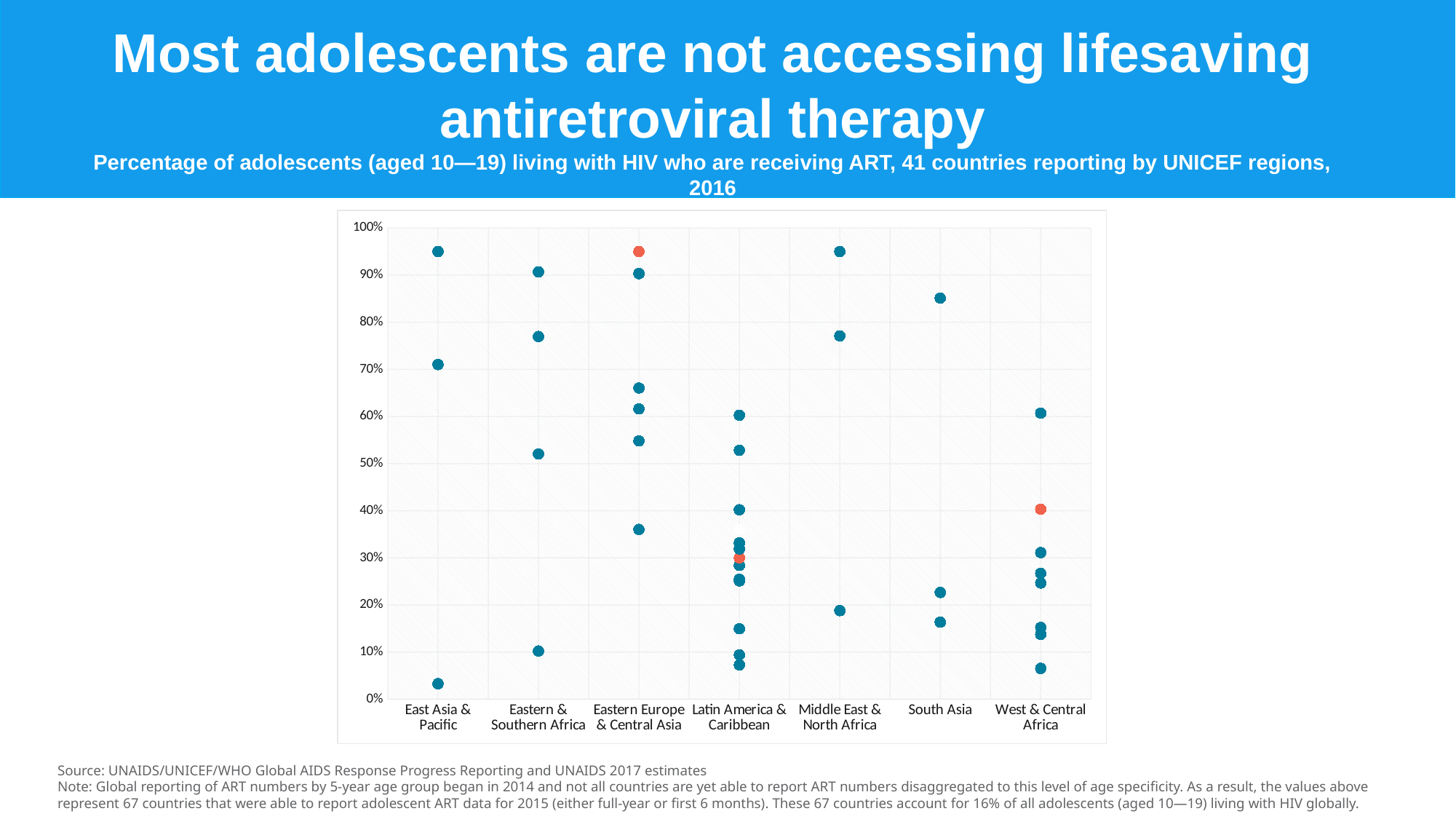
Is the highest value for South Asia greater or less than 80%? greater How many data points are plotted for South Asia? 3 Is the lowest value for Middle East & North Africa greater or less than 30%? less Is the lowest value for East Asia & Pacific greater or less than 10%? less How many UNICEF regions are shown along the x axis? 7 How many data points are plotted for Eastern & Southern Africa? 4 What kind of chart is shown on the slide? scatter (dot) plot What is the maximum value shown on the y axis? 100%